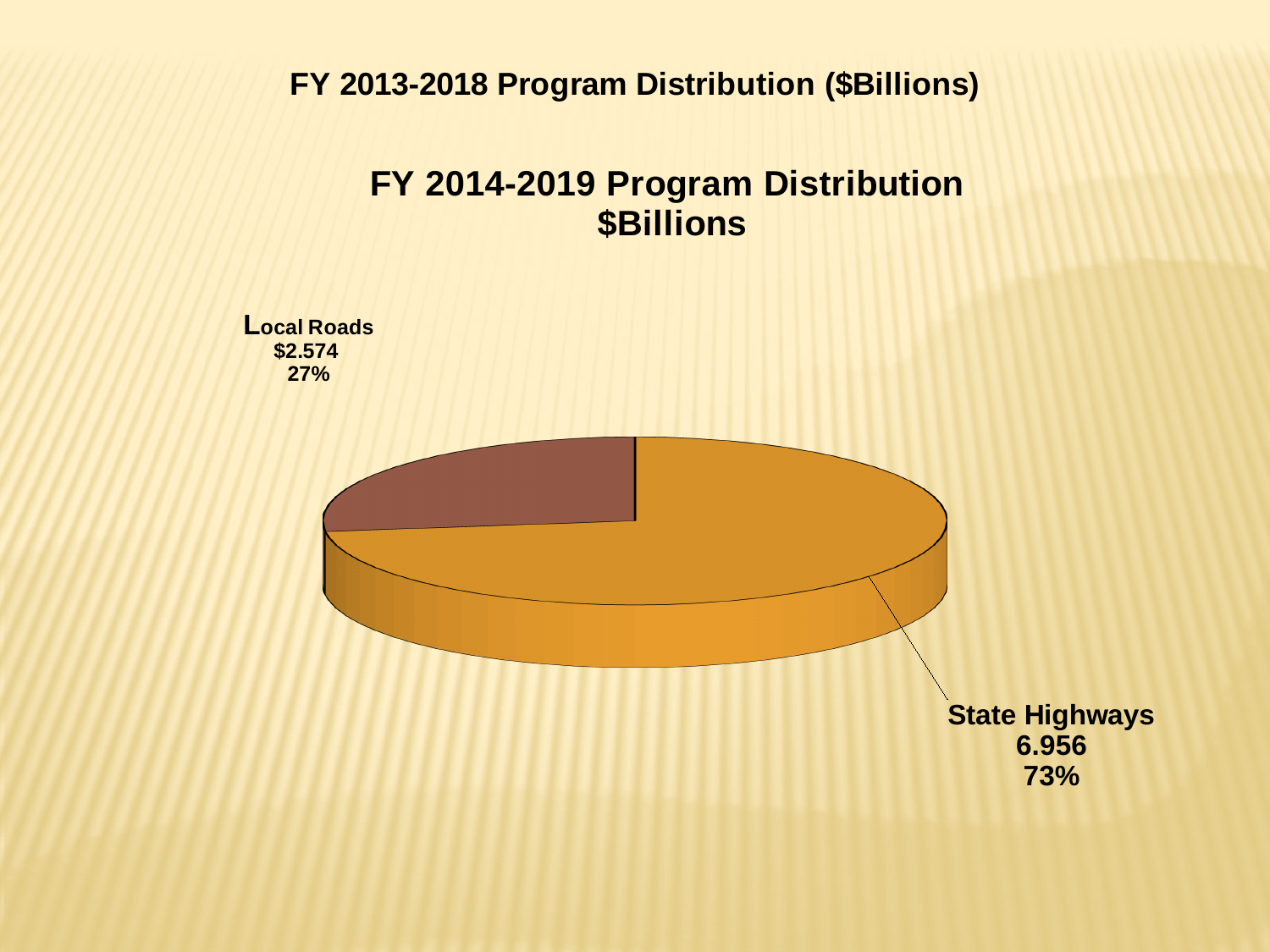
What percentage of the pie does Local Roads represent? 27% Which is larger, State Highways or Local Roads? State Highways Which category has the smallest slice of the pie? Local Roads What is the value shown for Local Roads? $2.574 What is the value shown for State Highways? 6.956 What kind of chart is shown on the slide? Pie chart What colour is the State Highways slice? Orange What percentage of the pie does State Highways represent? 73% How many slices does the pie chart have? 2 What is the title of the pie chart? FY 2014-2019 Program Distribution $Billions Which category has the largest slice of the pie? State Highways What is the difference between the State Highways value and the Local Roads value? 4.382